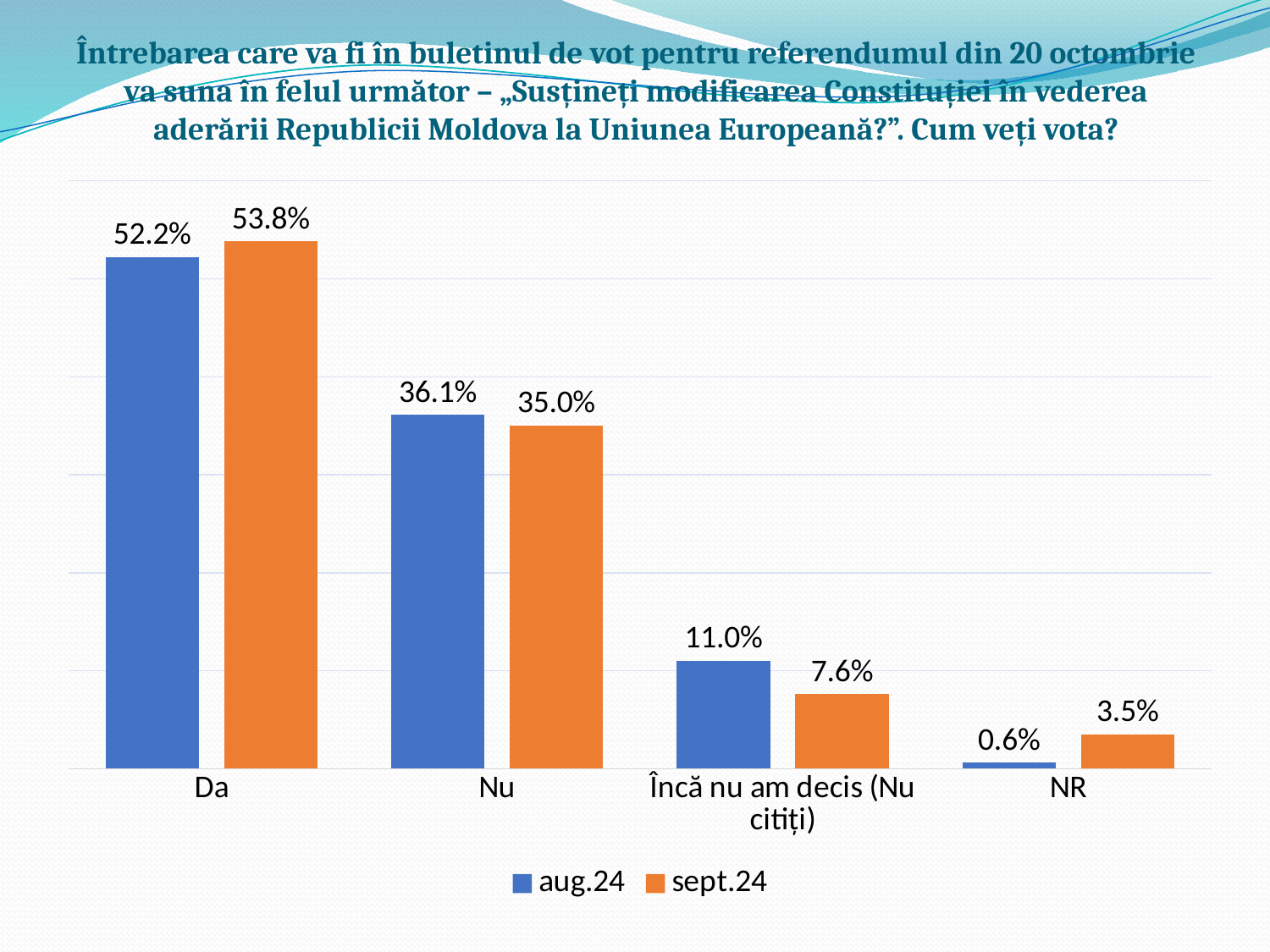
What is the value for "Încă nu am decis (Nu citiți)" in the aug.24 series? 11.0% Which category has the highest value in the sept.24 series? Da What kind of chart is shown on the slide? Bar chart Which is larger for "Nu": the aug.24 value or the sept.24 value? aug.24 How many series does the legend list? 2 What is the value for "Nu" in the sept.24 series? 35.0% What is the value for "Da" in the aug.24 series? 52.2% What is the value for "NR" in the sept.24 series? 3.5% How many categories are shown on the x axis? 4 What is the difference between the aug.24 and sept.24 values for "Încă nu am decis (Nu citiți)"? 3.4% What is the difference between the sept.24 and aug.24 values for "Da"? 1.6% Which category has the lowest value in the aug.24 series? NR